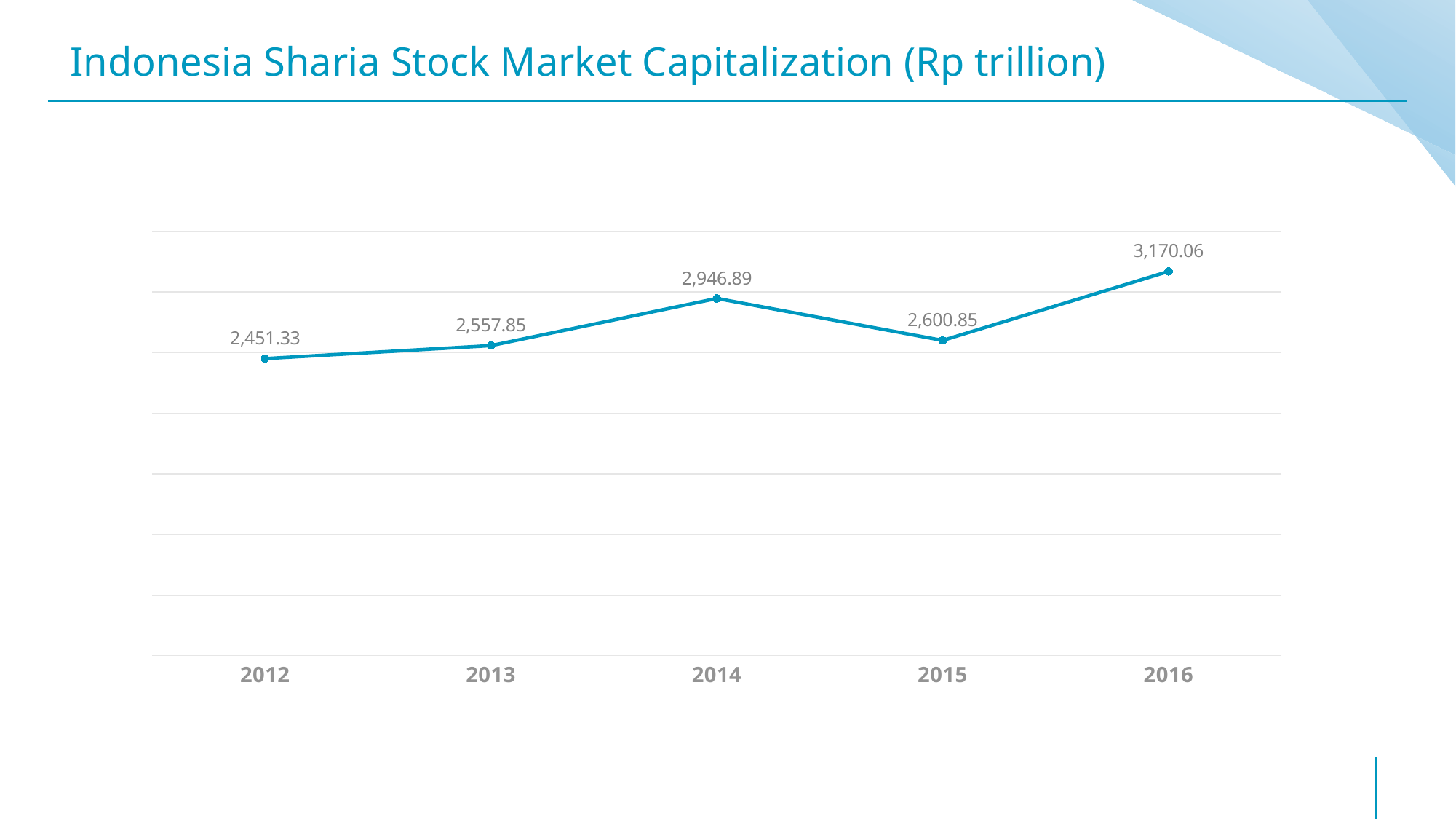
What is the difference between the 2014 and 2015 values? 346.04 Which year has a larger value, 2013 or 2015? 2015 What kind of chart is shown on the slide? Line chart Which year has the lowest market capitalization? 2012 What is the value plotted for 2014? 2,946.89 Does the value rise or fall from 2014 to 2015? Fall How many years are plotted on the chart? 5 What is the value plotted for 2015? 2,600.85 What is the Indonesia Sharia stock market capitalization for 2012? 2,451.33 Which year has the highest market capitalization? 2016 What is the value plotted for 2016? 3,170.06 By how much did the market capitalization increase from 2012 to 2016? 718.73